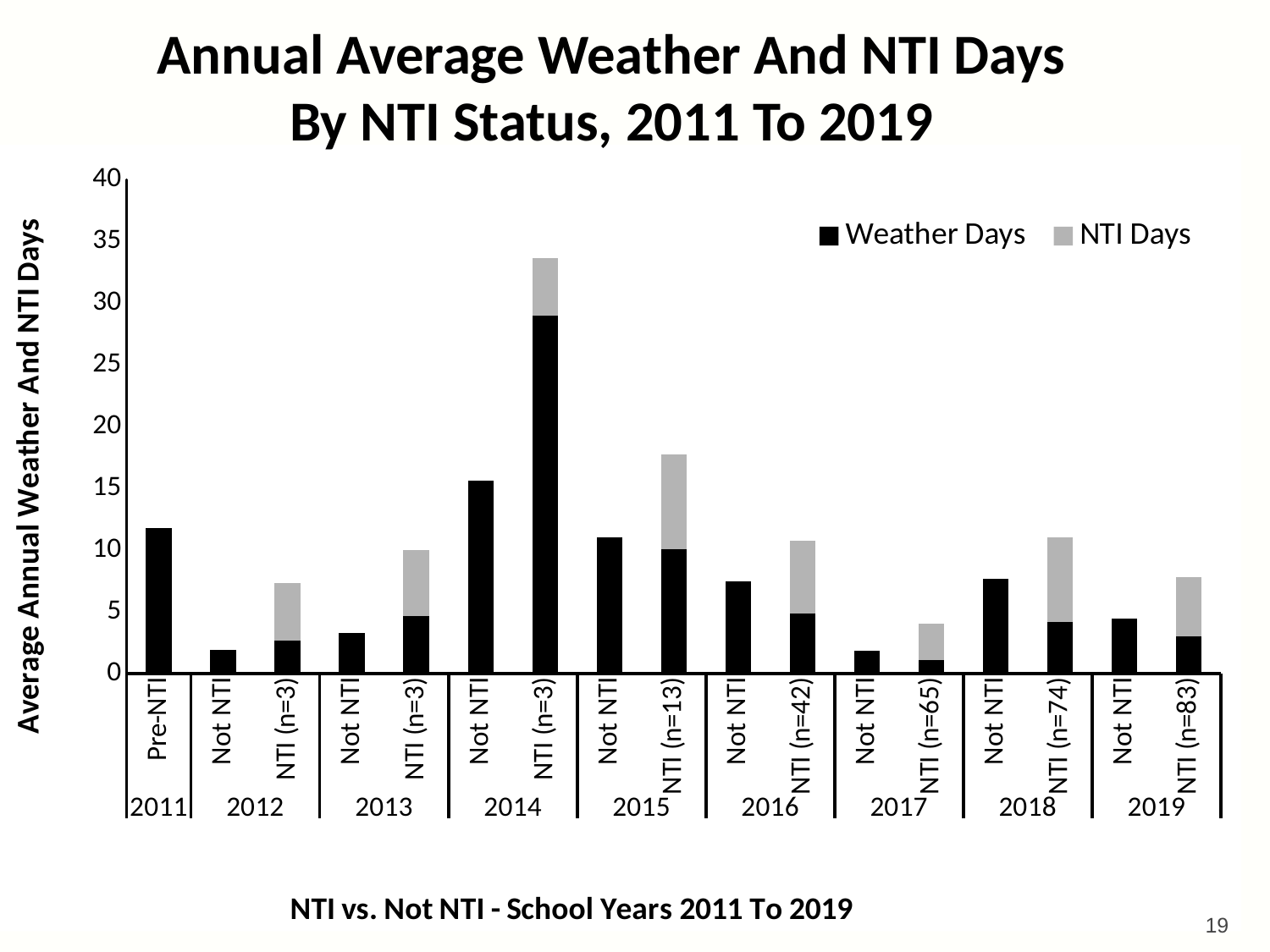
How many bars are plotted in the chart? 17 In 2015, which bar is taller: Not NTI or NTI (n=13)? NTI (n=13) Among the stacked NTI bars (2012 to 2019), which year has the shortest bar? 2017 NTI (n=65) Is the value for the 2014 Not NTI bar greater or less than 20? less Which bar is the tallest in the chart? 2014 NTI (n=3) Which colour represents NTI Days in the legend? Gray Is the total for the 2014 NTI (n=3) bar greater or less than 30? greater Is the total for the 2017 NTI (n=65) bar greater or less than 5? less What kind of chart is shown on the slide? Stacked bar chart How many series does the legend list? 2 Which Not NTI bar is taller: 2016 or 2017? 2016